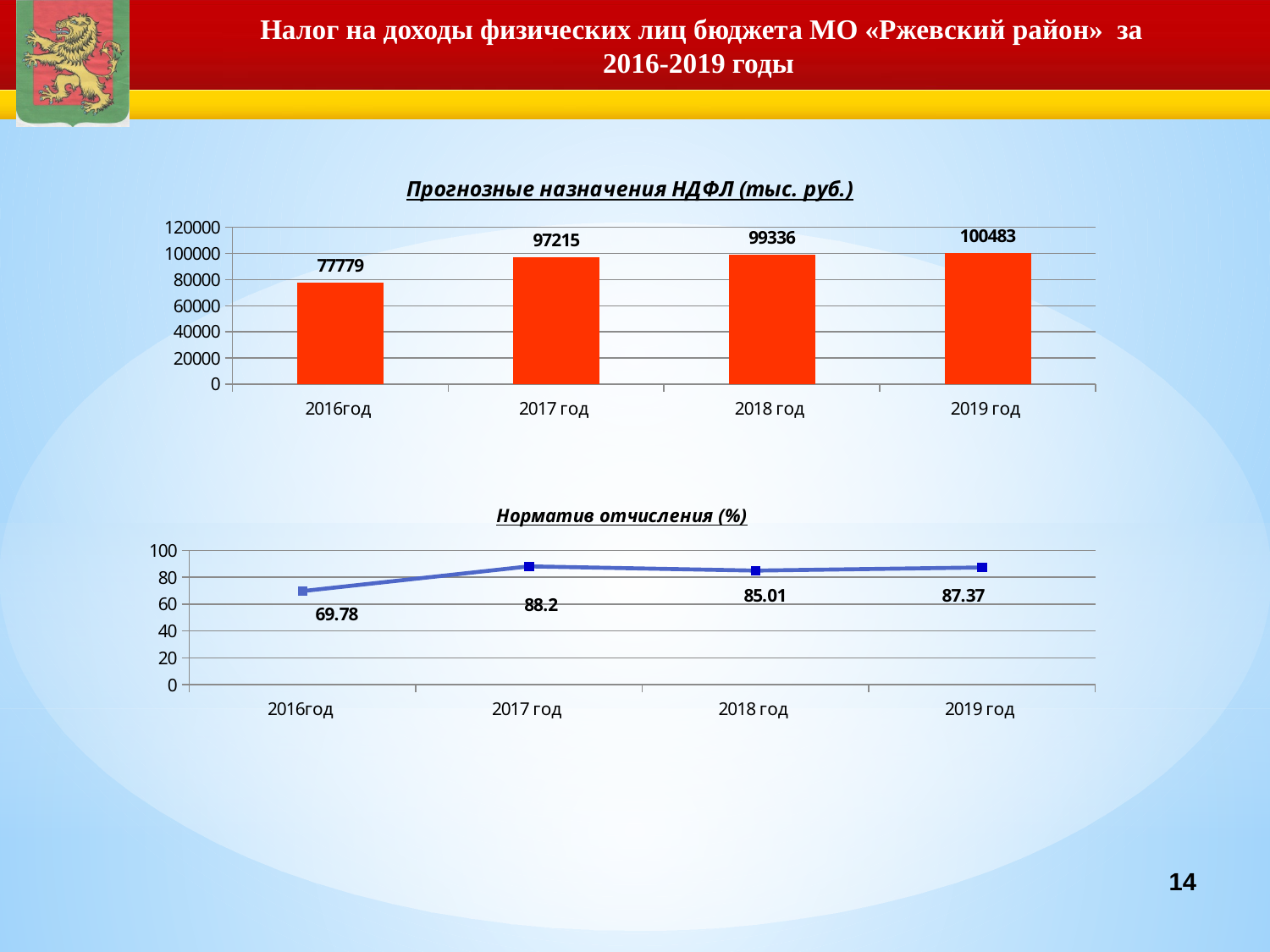
In the bottom chart 'Норматив отчисления (%)', what is the value for 2018 год? 85.01 In the top chart 'Прогнозные назначения НДФЛ (тыс. руб.)', what is the value for 2016год? 77779 In the top chart 'Прогнозные назначения НДФЛ (тыс. руб.)', what is the difference between the values for 2017 год and 2016год? 19436 In the top chart 'Прогнозные назначения НДФЛ (тыс. руб.)', which year has the highest value? 2019 год In the top chart 'Прогнозные назначения НДФЛ (тыс. руб.)', which year has the lowest value? 2016год What kind of chart is the top chart 'Прогнозные назначения НДФЛ (тыс. руб.)'? bar chart In the top chart 'Прогнозные назначения НДФЛ (тыс. руб.)', what is the value for 2019 год? 100483 In the bottom chart 'Норматив отчисления (%)', what is the value for 2017 год? 88.2 In the top chart 'Прогнозные назначения НДФЛ (тыс. руб.)', do the values rise or fall from 2016год to 2019 год? rise How many data points does the bottom chart 'Норматив отчисления (%)' show? 4 In the bottom chart 'Норматив отчисления (%)', is the value for 2019 год larger or smaller than the value for 2018 год? larger In the bottom chart 'Норматив отчисления (%)', which year has the lowest value? 2016год